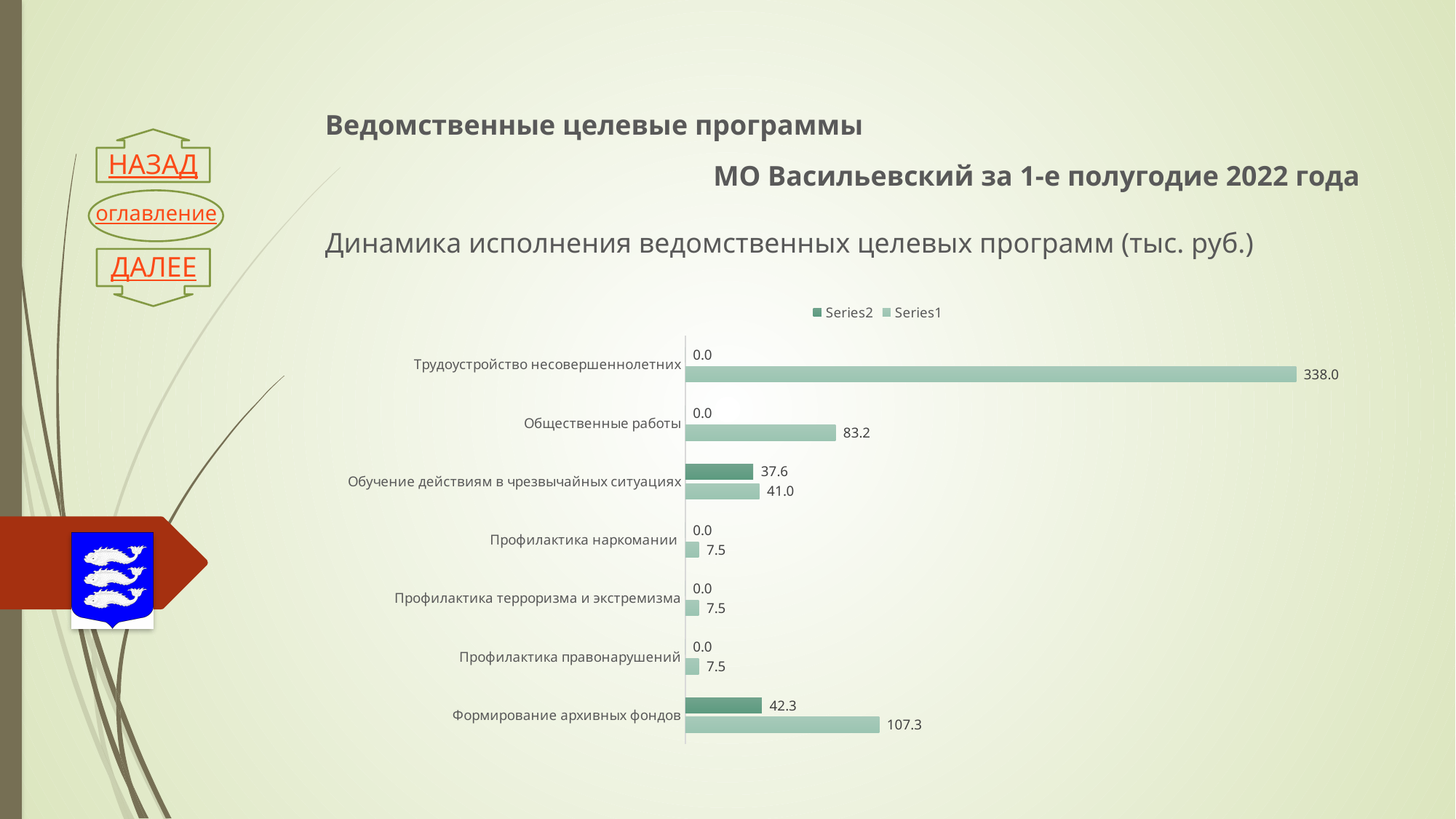
How many categories are shown on the chart? 7 What is the Series1 value for Формирование архивных фондов? 107.3 Which category has the highest Series1 value? Трудоустройство несовершеннолетних What is the Series2 value for Обучение действиям в чрезвычайных ситуациях? 37.6 How many series does the legend list? 2 What is the Series1 value for Профилактика наркомании? 7.5 Which is larger: the Series1 value for Общественные работы or the Series1 value for Формирование архивных фондов? Формирование архивных фондов What type of chart is shown on the slide? Bar chart What is the difference between the Series1 values for Трудоустройство несовершеннолетних and Общественные работы? 254.8 Which category has the highest Series2 value? Формирование архивных фондов What is the difference between the Series1 and Series2 values for Формирование архивных фондов? 65.0 What is the Series1 value for Трудоустройство несовершеннолетних? 338.0